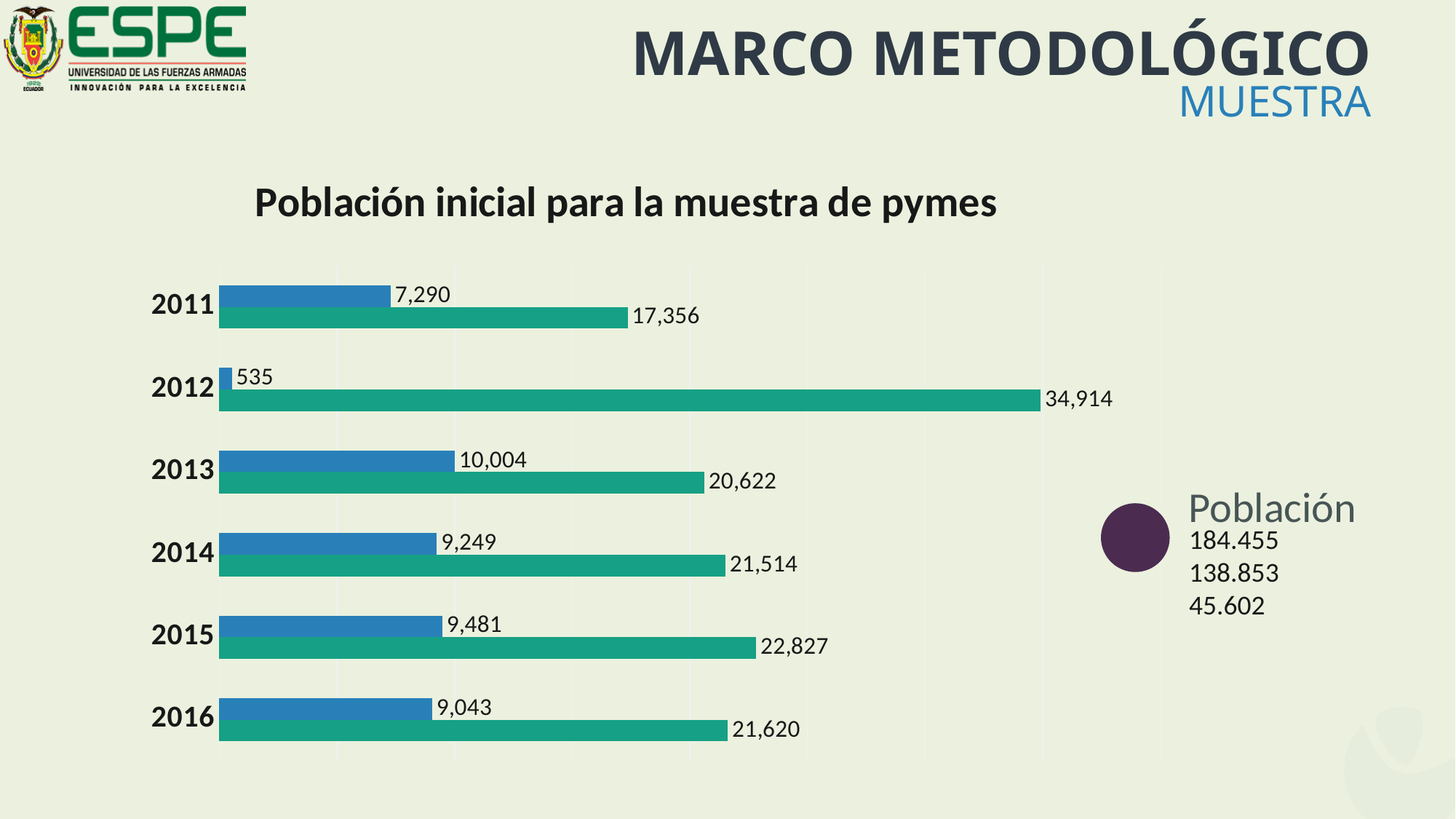
What is the difference between the green bar and the blue bar for 2015? 13,346 Which year has the lowest value for the blue bar? 2012 What is the value of the blue bar for 2011? 7,290 What is the title of the chart? Población inicial para la muestra de pymes How many years are shown on the chart? 6 What is the value of the green bar for 2012? 34,914 Which year has the highest value for the green bar? 2012 What is the difference between the green bar values for 2014 and 2013? 892 What is the value of the green bar for 2016? 21,620 What is the value of the blue bar for 2013? 10,004 Which is larger, the blue bar for 2014 or the blue bar for 2015? 2015 What type of chart is shown on the slide? bar chart